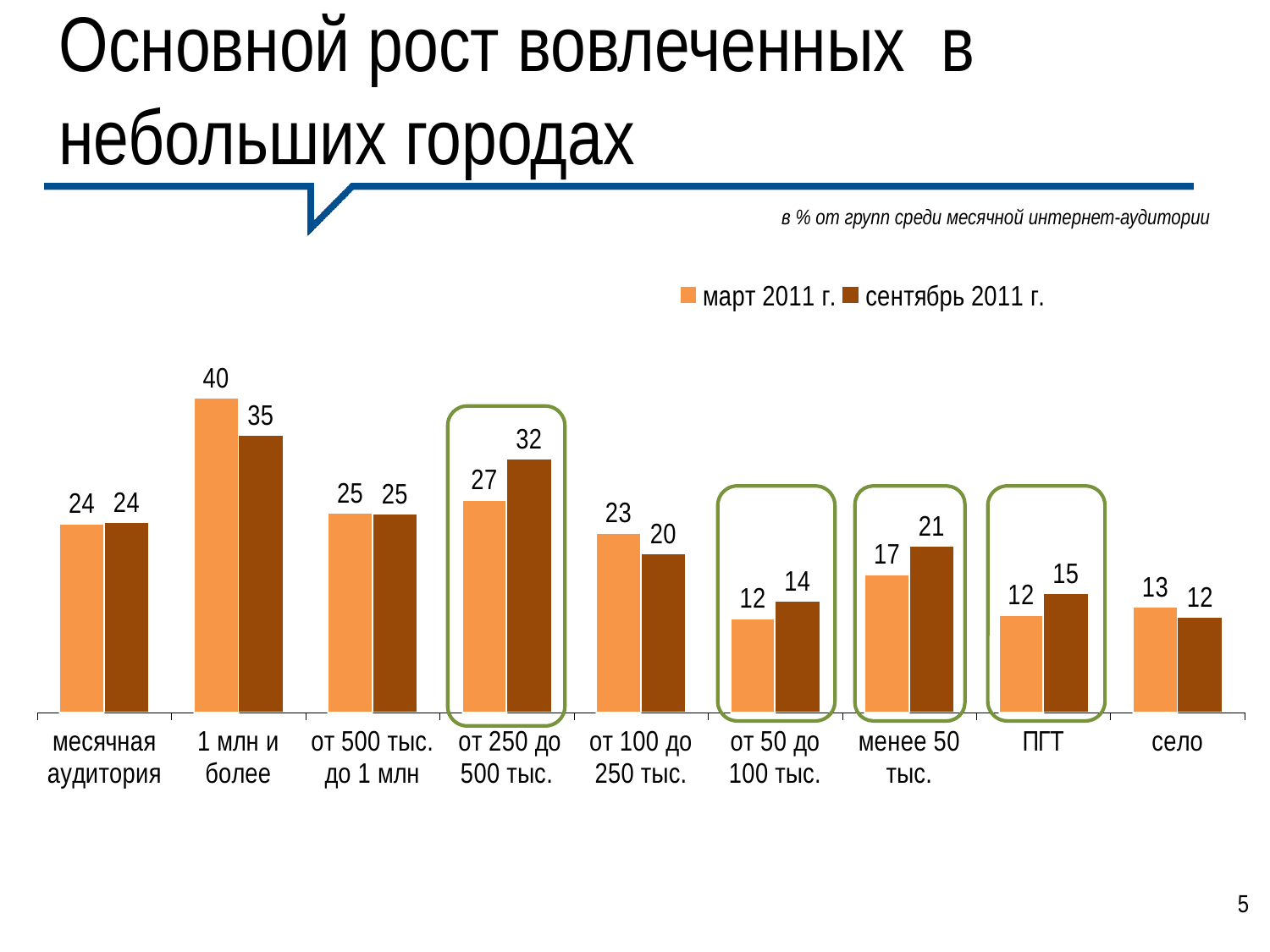
What is the difference between the "март 2011 г." and "сентябрь 2011 г." values for "1 млн и более"? 5 What is the value for "ПГТ" in the "март 2011 г." series? 12 For "менее 50 тыс.", which series has the larger value, "март 2011 г." or "сентябрь 2011 г."? сентябрь 2011 г. Which category has the lowest value in the "сентябрь 2011 г." series? село What is the difference between the "сентябрь 2011 г." and "март 2011 г." values for "от 250 до 500 тыс."? 5 What kind of chart is shown on the slide? bar chart For "от 100 до 250 тыс.", which series has the larger value, "март 2011 г." or "сентябрь 2011 г."? март 2011 г. What is the value for "1 млн и более" in the "март 2011 г." series? 40 Which category has the highest value in the "сентябрь 2011 г." series? 1 млн и более How many series does the legend list? 2 What is the value for "от 250 до 500 тыс." in the "сентябрь 2011 г." series? 32 How many categories are shown on the x axis of the chart? 9